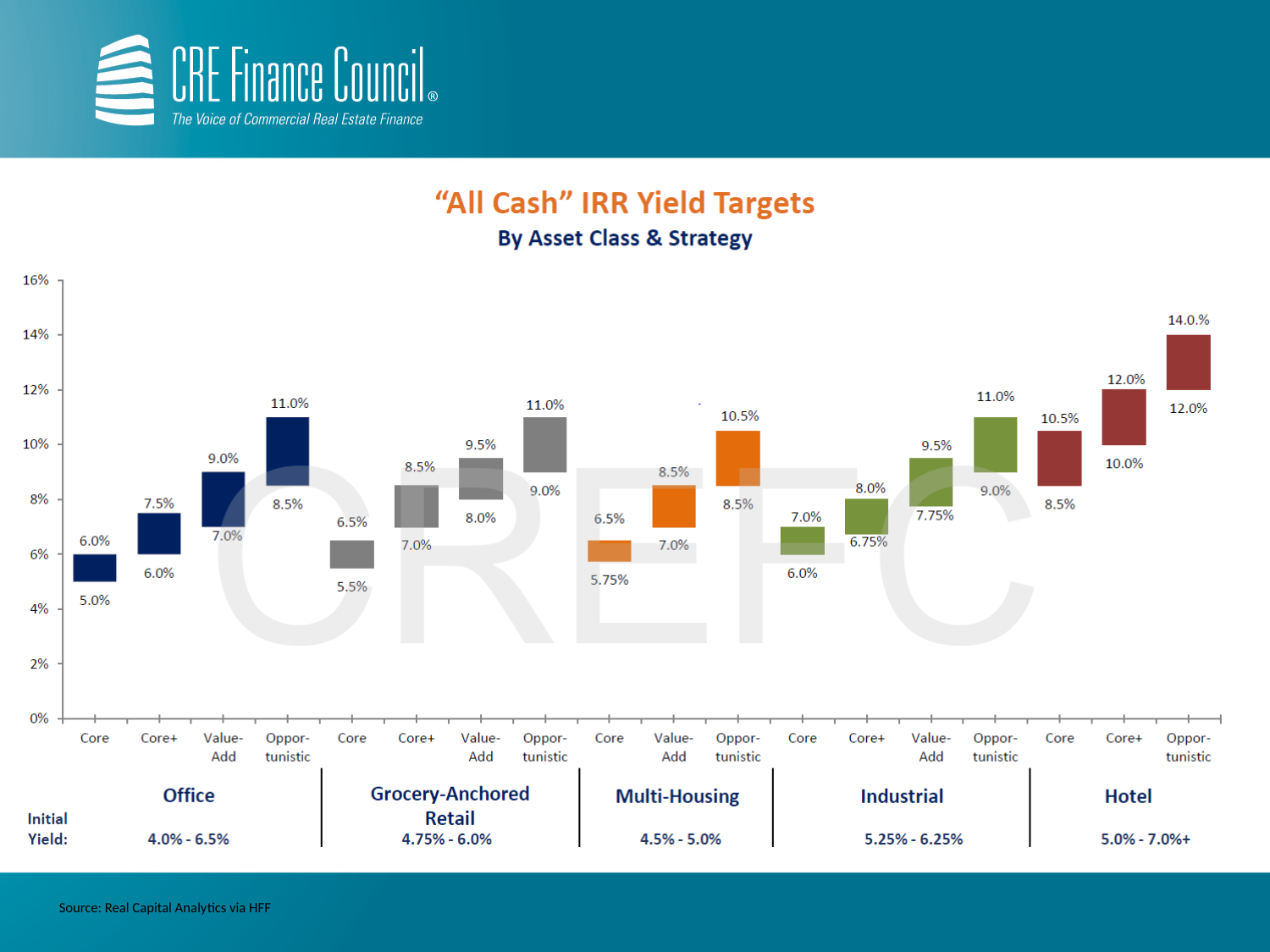
Which has a higher upper IRR yield target: Office Core+ or Grocery-Anchored Retail Core+? Grocery-Anchored Retail Core+ What is the lower end of the IRR yield target range for Industrial Value-Add? 7.75% How many strategy bars are plotted in the chart in total? 18 Which asset class and strategy has the lowest lower IRR yield target? Office Core (5.0%) What is the upper end of the IRR yield target range for Office Opportunistic? 11.0% What is the difference between the upper and lower ends of the Hotel Opportunistic IRR yield target range? 2.0% What is the lower end of the IRR yield target range for Multi-Housing Core? 5.75% What kind of chart is shown on the slide? Bar chart Which asset class and strategy has the highest upper IRR yield target? Hotel Opportunistic (14.0%) Is the upper end of the Industrial Core IRR yield target greater or less than 8%? less What is the upper end of the IRR yield target range for Hotel Core+? 12.0% What is the initial yield range shown for Industrial? 5.25% - 6.25%